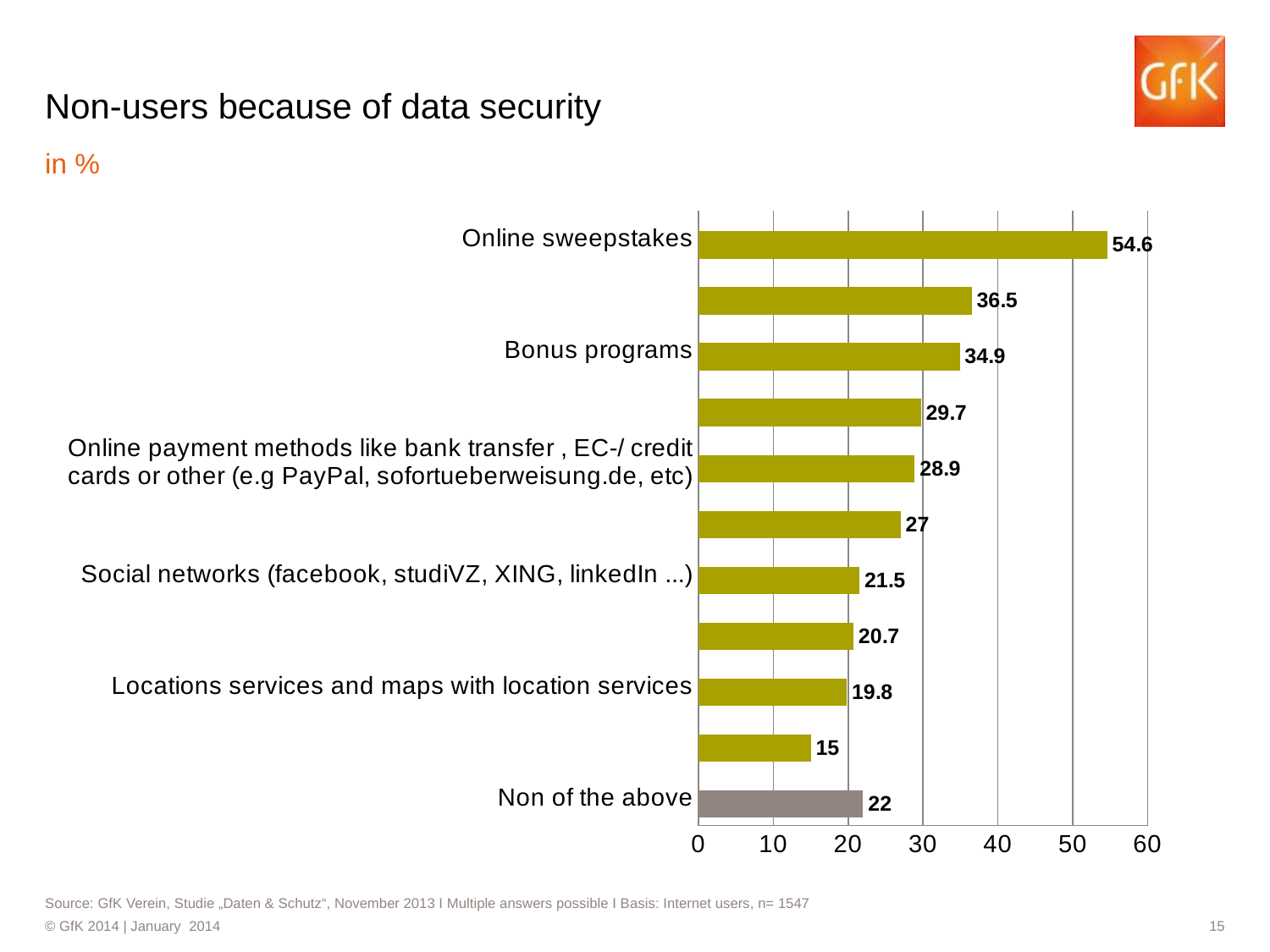
What is the value for Social networks (facebook, studiVZ, XING, linkedIn ...)? 21.5 What is the lowest value shown on the chart? 15 How many bars are shown on the chart? 11 What is the difference between the values for Online sweepstakes and Bonus programs? 19.7 What is the value for Online payment methods like bank transfer, EC-/ credit cards or other? 28.9 What is the value for Locations services and maps with location services? 19.8 What is the value for Non of the above? 22 What is the value for Online sweepstakes? 54.6 Which is larger, the value for Non of the above or the value for Social networks? Non of the above Which category has the highest value? Online sweepstakes What is the value for Bonus programs? 34.9 What kind of chart is shown on the slide? Bar chart